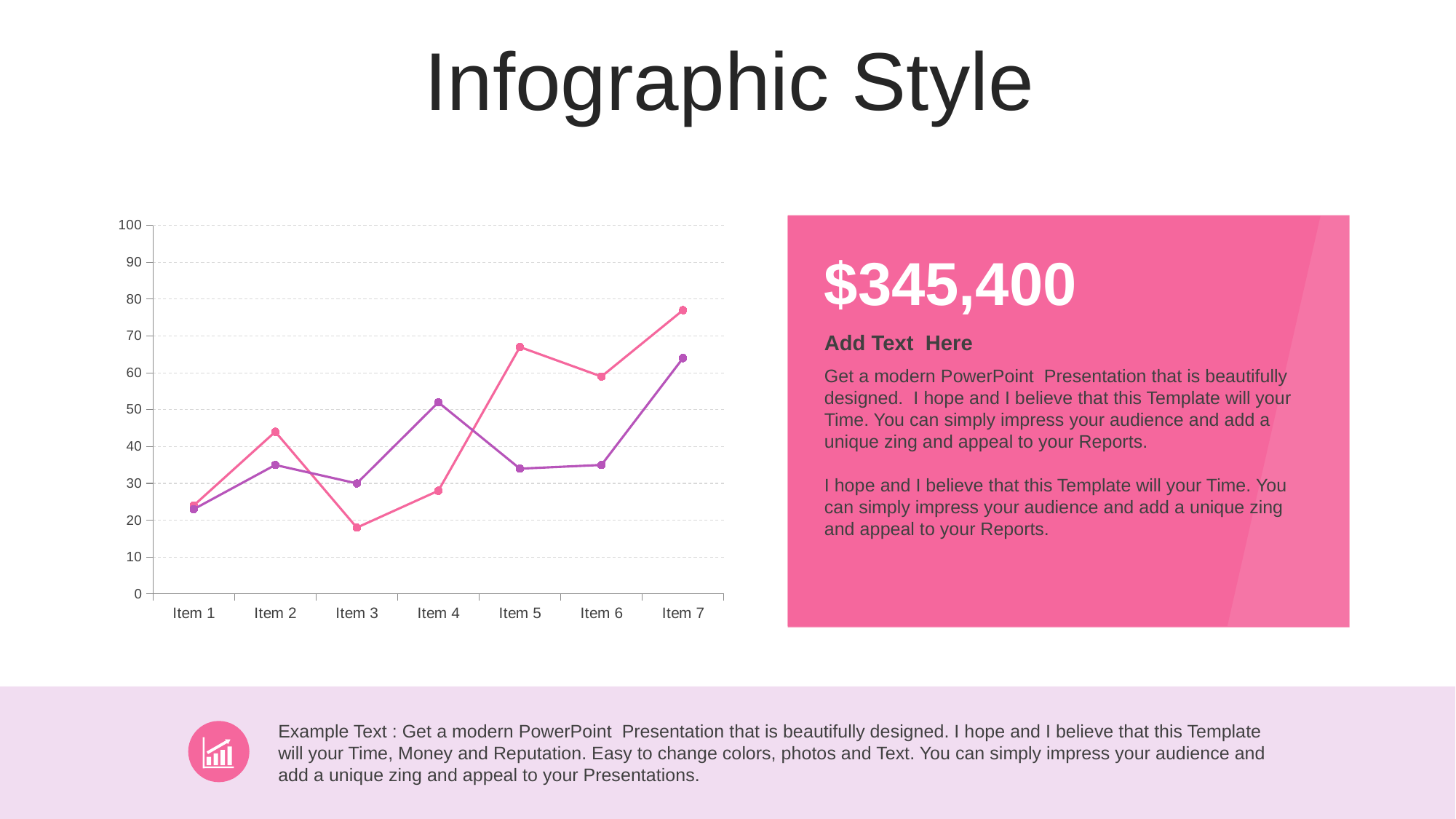
Is the value of the pink line at Item 7 greater or less than 70? greater At which item does the purple line reach its lowest value? Item 1 At which item does the pink line reach its highest value? Item 7 Is the value of the purple line at Item 4 greater or less than 40? greater How many lines are plotted on the chart? 2 How many categories are shown on the x axis of the chart? 7 At which item does the purple line reach its highest value? Item 7 At which item does the pink line reach its lowest value? Item 3 What kind of chart is shown on the slide? line chart At Item 4, which line has the higher value, the pink line or the purple line? the purple line Is the value of the pink line at Item 3 greater or less than 30? less At Item 5, which line has the higher value, the pink line or the purple line? the pink line